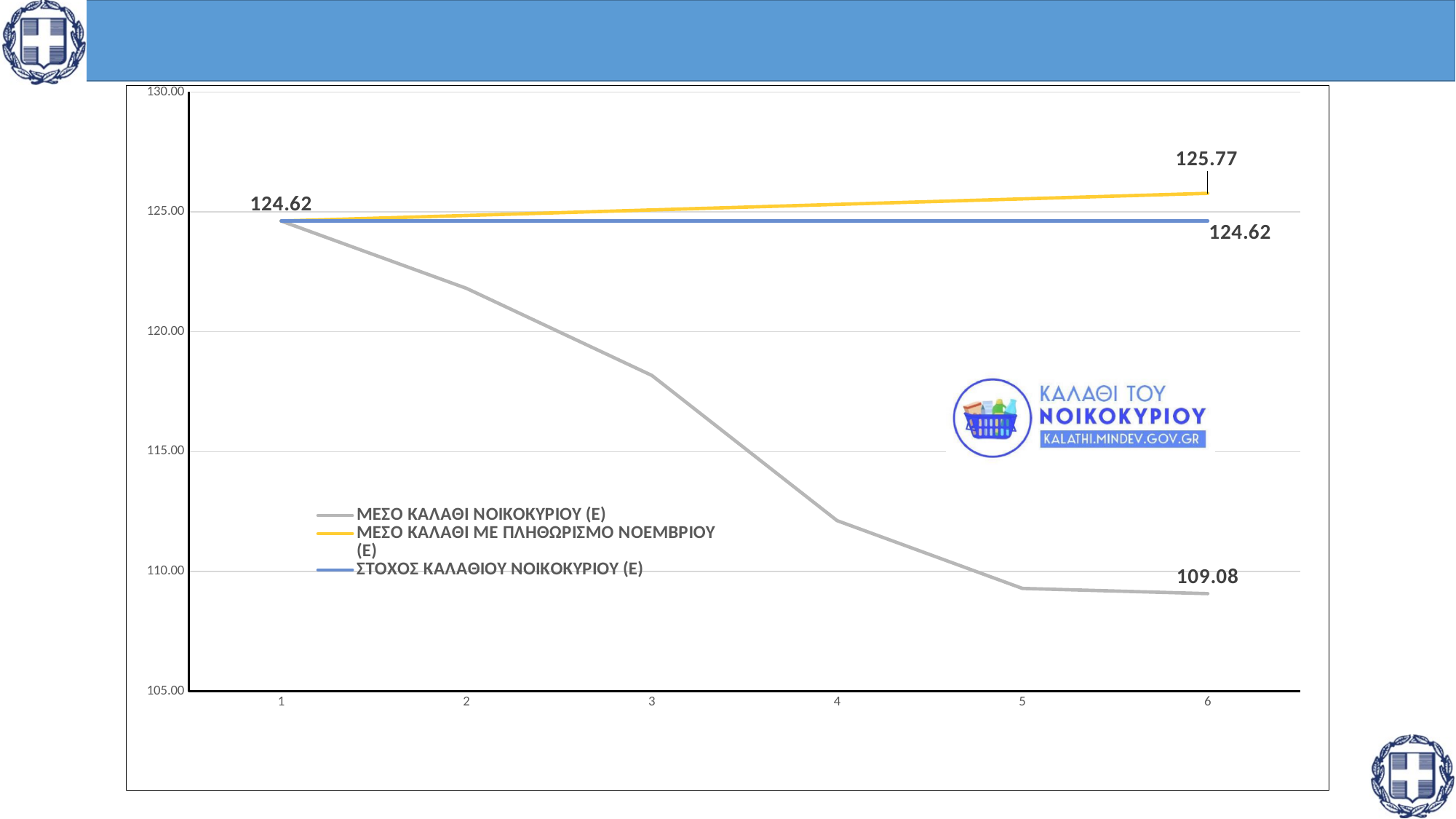
How many series does the legend list? 3 What is the value of ΜΕΣΟ ΚΑΛΑΘΙ ΜΕ ΠΛΗΘΩΡΙΣΜΟ ΝΟΕΜΒΡΙΟΥ (Ε) at point 6? 125.77 Does the ΜΕΣΟ ΚΑΛΑΘΙ ΝΟΙΚΟΚΥΡΙΟΥ (Ε) line rise or fall from point 1 to point 6? Fall How many points are plotted along the x axis? 6 What kind of chart is shown on the slide? Line chart At point 6, which is higher: ΜΕΣΟ ΚΑΛΑΘΙ ΜΕ ΠΛΗΘΩΡΙΣΜΟ ΝΟΕΜΒΡΙΟΥ (Ε) or ΜΕΣΟ ΚΑΛΑΘΙ ΝΟΙΚΟΚΥΡΙΟΥ (Ε)? ΜΕΣΟ ΚΑΛΑΘΙ ΜΕ ΠΛΗΘΩΡΙΣΜΟ ΝΟΕΜΒΡΙΟΥ (Ε) What is the difference between ΜΕΣΟ ΚΑΛΑΘΙ ΜΕ ΠΛΗΘΩΡΙΣΜΟ ΝΟΕΜΒΡΙΟΥ (Ε) and ΣΤΟΧΟΣ ΚΑΛΑΘΙΟΥ ΝΟΙΚΟΚΥΡΙΟΥ (Ε) at point 6? 1.15 What is the value of ΜΕΣΟ ΚΑΛΑΘΙ ΝΟΙΚΟΚΥΡΙΟΥ (Ε) at point 6? 109.08 What is the difference between ΣΤΟΧΟΣ ΚΑΛΑΘΙΟΥ ΝΟΙΚΟΚΥΡΙΟΥ (Ε) and ΜΕΣΟ ΚΑΛΑΘΙ ΝΟΙΚΟΚΥΡΙΟΥ (Ε) at point 6? 15.54 What is the value of ΣΤΟΧΟΣ ΚΑΛΑΘΙΟΥ ΝΟΙΚΟΚΥΡΙΟΥ (Ε) at point 6? 124.62 What value do the series start at, at point 1? 124.62 Is the value of ΜΕΣΟ ΚΑΛΑΘΙ ΝΟΙΚΟΚΥΡΙΟΥ (Ε) at point 4 greater or less than 115.00? less